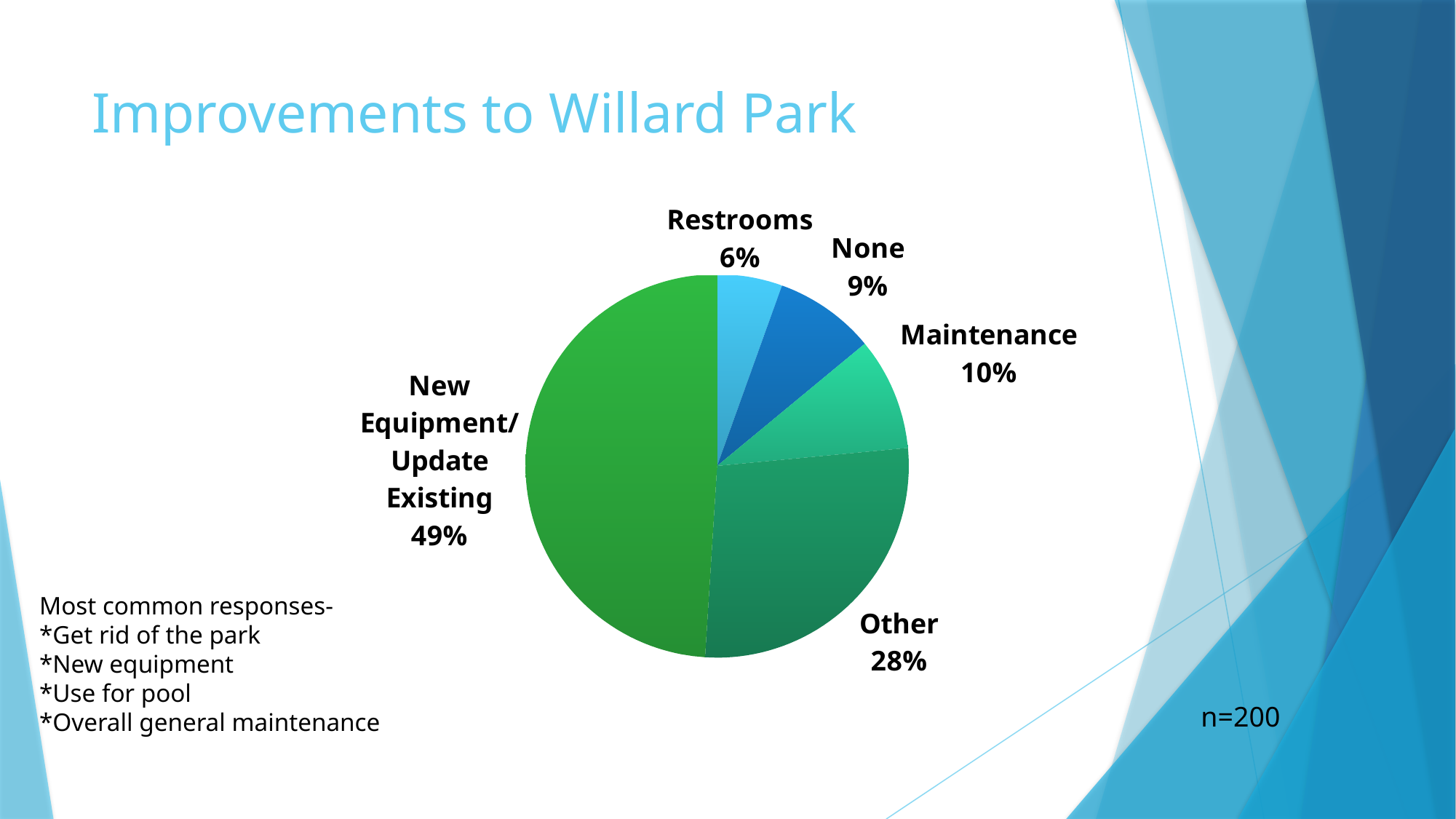
Which category has the largest slice of the pie? New Equipment/Update Existing How many categories are shown in the pie chart? 5 What sample size (n) is noted on the slide? n=200 What share of the pie does New Equipment/Update Existing account for? 49% What is the value shown for Maintenance? 10% Which category has the smallest slice of the pie? Restrooms What kind of chart is shown on the slide? Pie chart What is the value shown for Other? 28% What is the title of the slide containing the chart? Improvements to Willard Park What is the value shown for Restrooms? 6% Which is larger, Maintenance or None? Maintenance What is the difference in percentage points between Other and None? 19